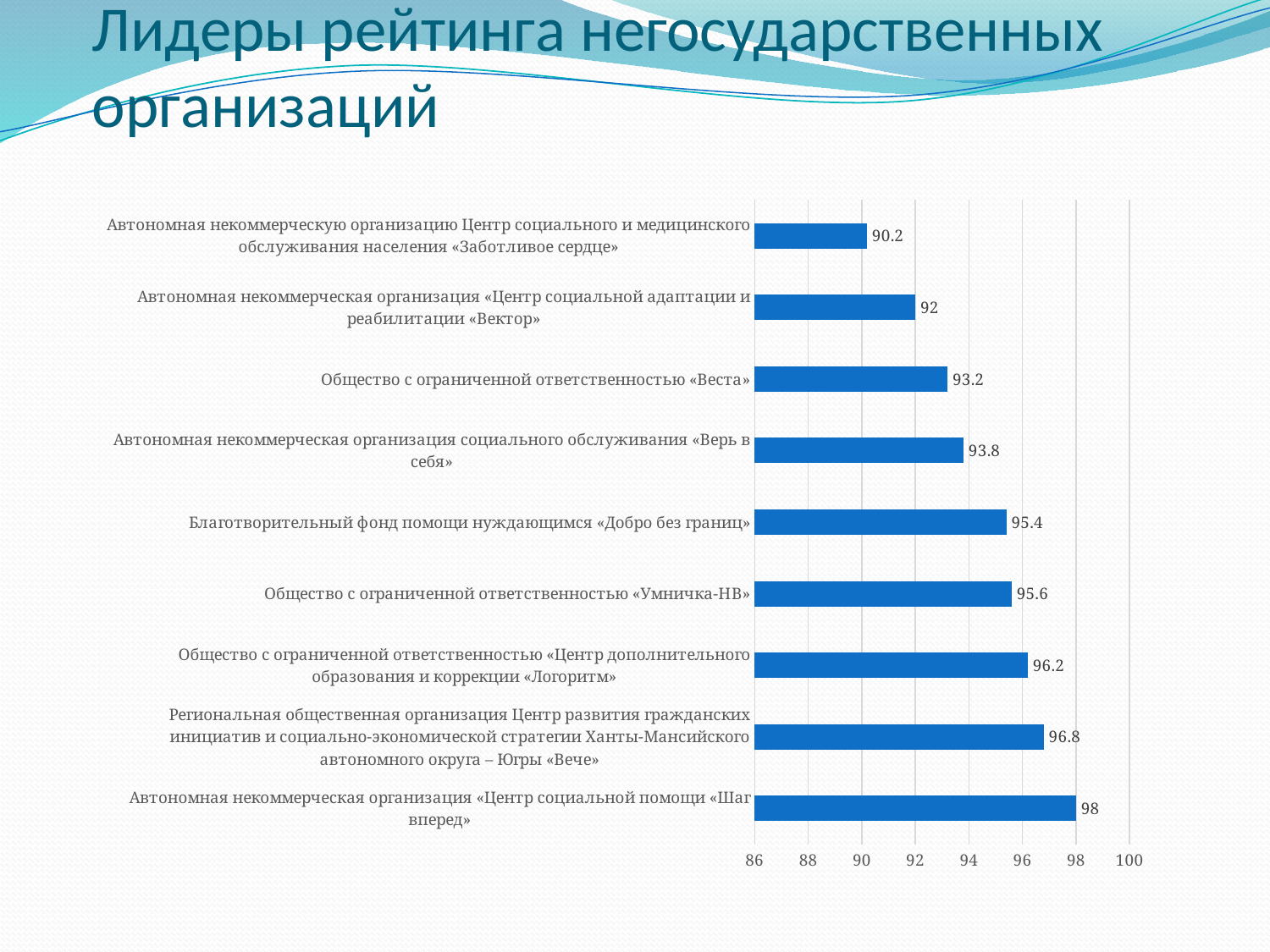
What value is shown for Общество с ограниченной ответственностью «Веста»? 93.2 What type of chart is shown on the slide? Bar chart Is the value for «Умничка-НВ» greater or less than 94? greater What is the difference between the values for «Шаг вперед» and «Заботливое сердце»? 7.8 How many organizations are shown on the chart? 9 Which has a larger value, «Верь в себя» or «Веста»? «Верь в себя» Which organization has the lowest value on the chart? Автономная некоммерческую организацию Центр социального и медицинского обслуживания населения «Заботливое сердце» What value is shown for «Шаг вперед»? 98 Which organization has the highest value on the chart? Автономная некоммерческая организация «Центр социальной помощи «Шаг вперед» What value is shown for Благотворительный фонд помощи нуждающимся «Добро без границ»? 95.4 What value is shown for «Центр социальной адаптации и реабилитации «Вектор»? 92 What is the difference between the values for «Вече» and «Логоритм»? 0.6